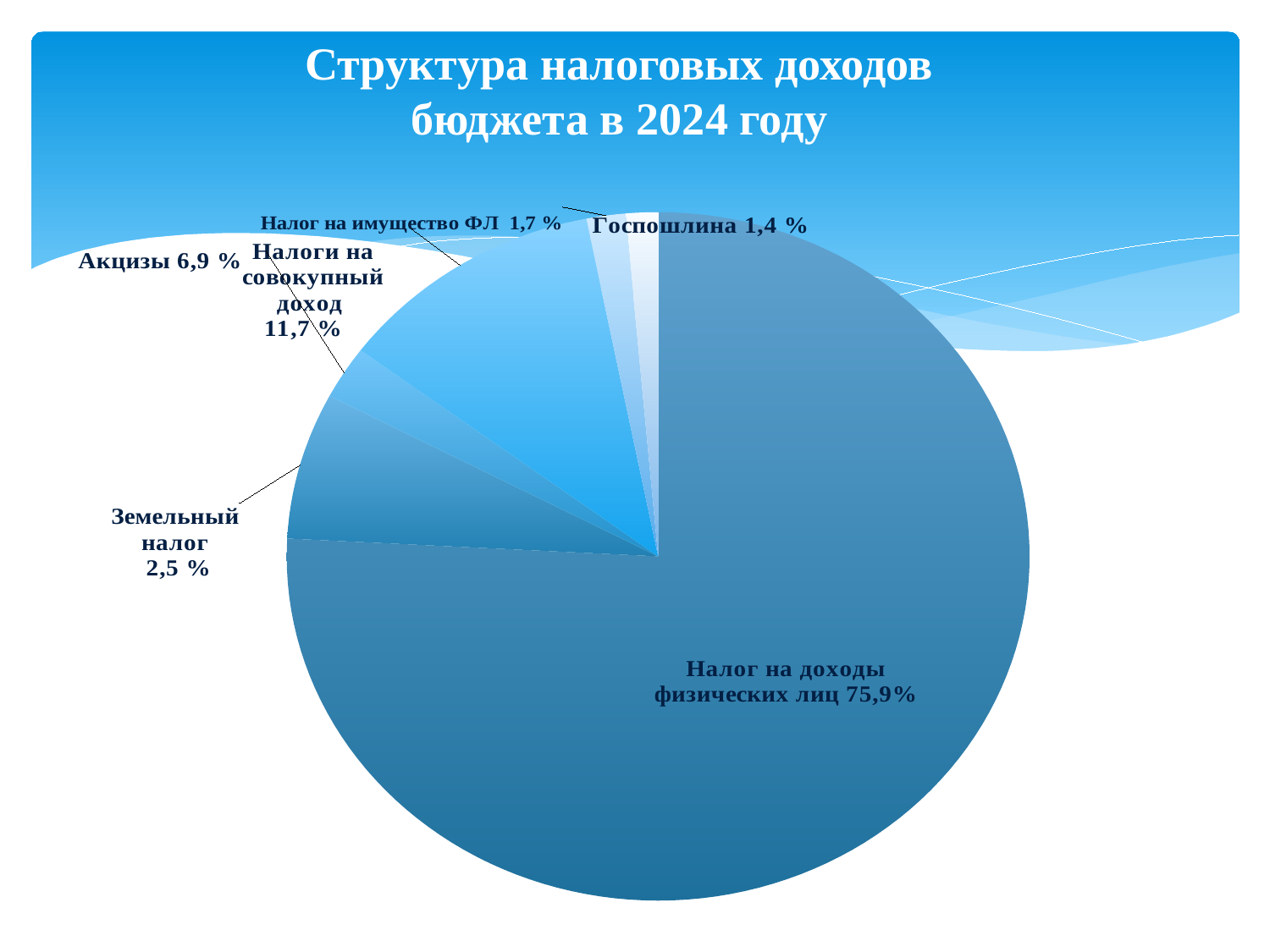
Which is larger, the share of Земельный налог or the share of Налог на имущество ФЛ? Земельный налог What is the value shown for Земельный налог? 2,5 % What is the title of the chart? Структура налоговых доходов бюджета в 2024 году What type of chart is shown on the slide? Pie chart How many slices does the pie chart have? 6 What is the value shown for Налоги на совокупный доход? 11,7 % Which category has the smallest slice of the pie? Госпошлина Which category has the largest slice of the pie? Налог на доходы физических лиц What share of the pie is Налог на доходы физических лиц? 75,9% What is the value shown for Акцизы? 6,9 % What is the value shown for Госпошлина? 1,4 % What is the difference between the shares of Налоги на совокупный доход and Акцизы? 4,8 %